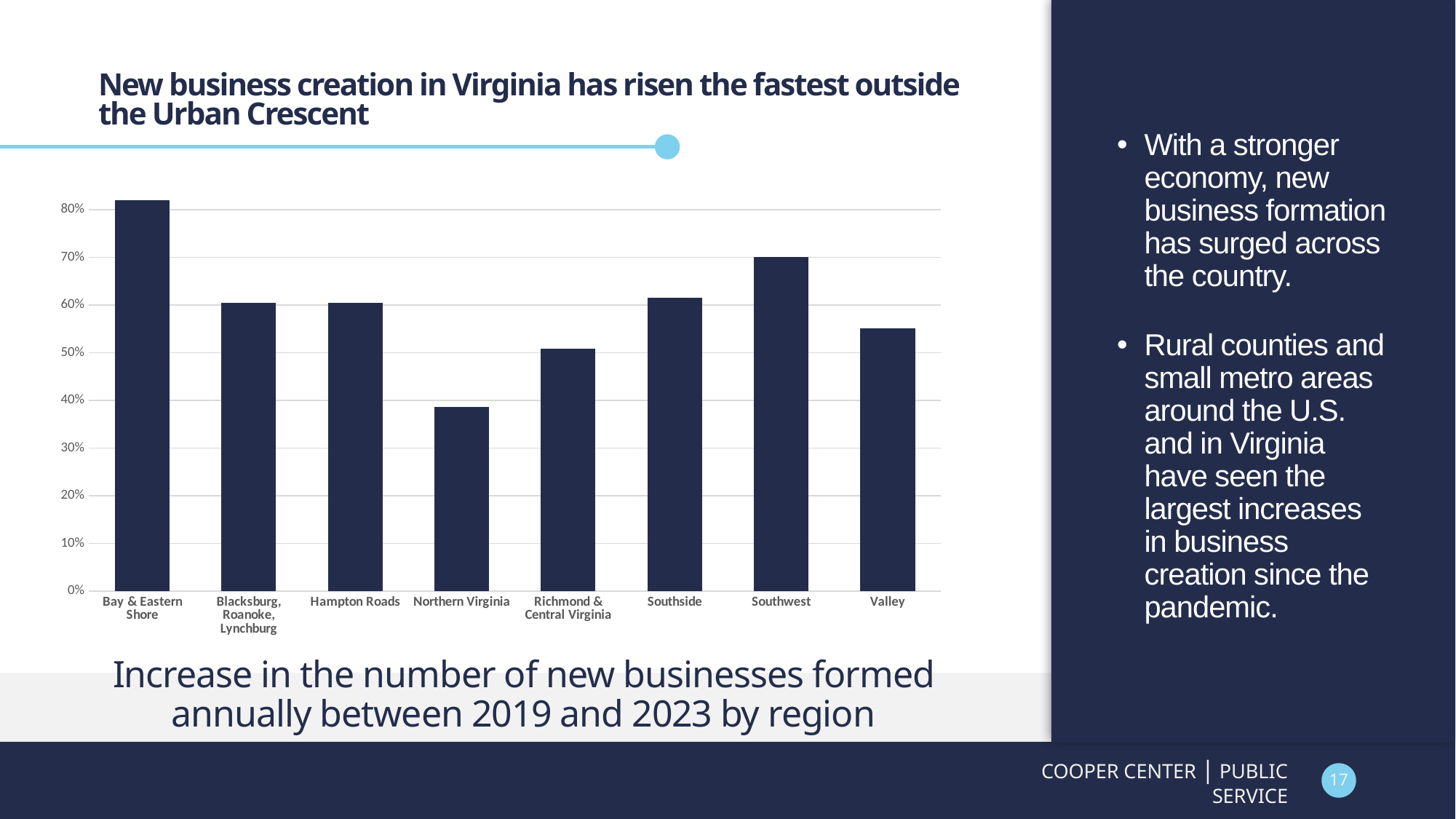
Which is larger, the value for Northern Virginia or the value for Richmond & Central Virginia? Richmond & Central Virginia Is the value for Southside greater or less than 50%? greater What is the title of the slide above the chart? New business creation in Virginia has risen the fastest outside the Urban Crescent Is the value for Northern Virginia greater or less than 50%? less Which region has the lowest increase in new businesses formed? Northern Virginia Is the value for Valley greater or less than 60%? less Which region has the highest increase in new businesses formed? Bay & Eastern Shore Which is larger, the value for Southwest or the value for Valley? Southwest What does the caption below the chart say the chart shows? Increase in the number of new businesses formed annually between 2019 and 2023 by region How many regions are shown on the x axis of the chart? 8 What kind of chart is shown on the slide? Bar chart